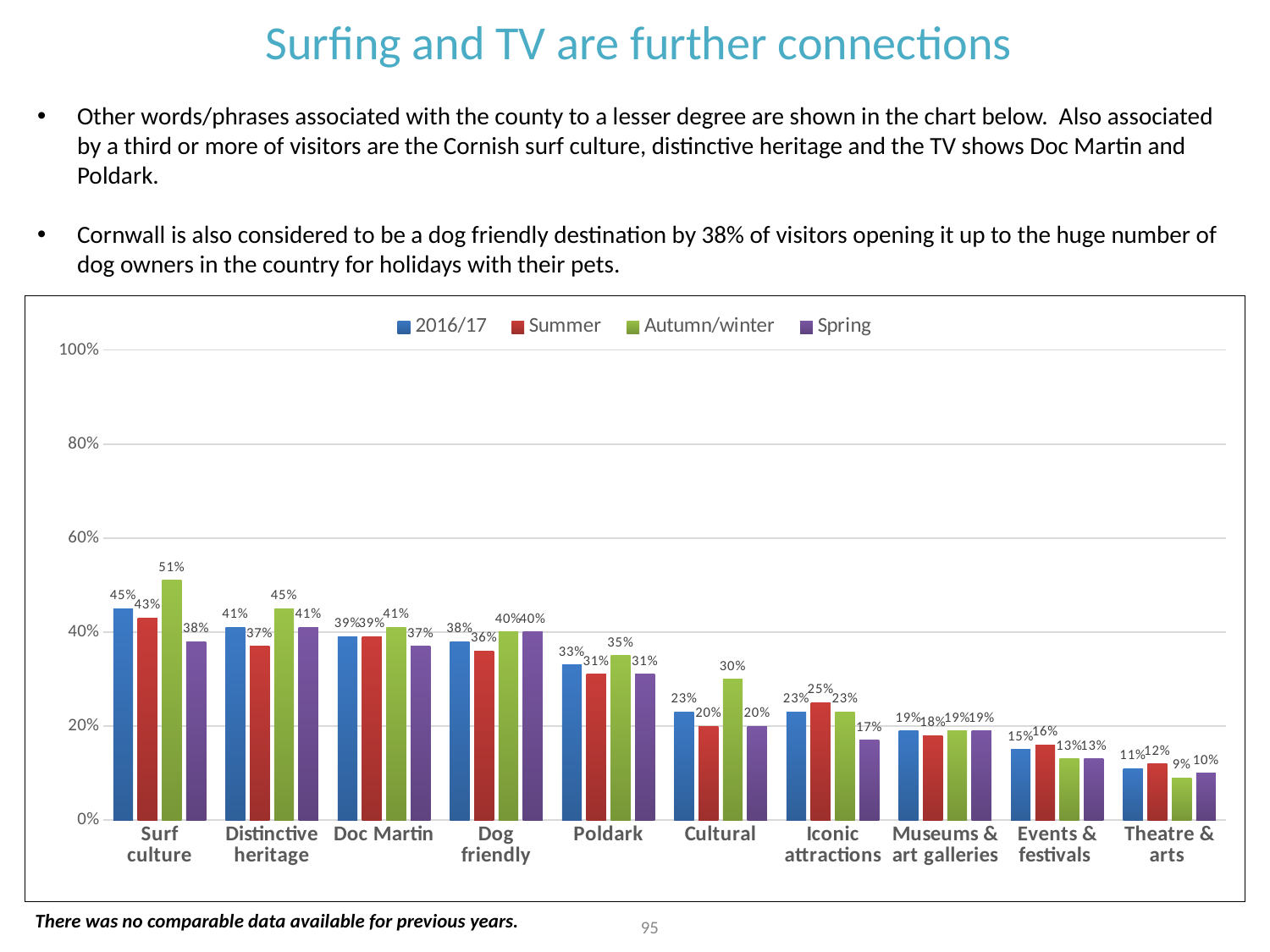
Which category has the highest Autumn/winter value? Surf culture What is the 2016/17 value for Dog friendly? 38% Which category has the lowest 2016/17 value? Theatre & arts How many series does the chart legend list? 4 Which is larger for Cultural: the Autumn/winter value or the Summer value? Autumn/winter What kind of chart is shown on the slide? Bar chart What is the Spring value for Iconic attractions? 17% What is the Autumn/winter value for Surf culture? 51% How many categories are shown on the x axis of the chart? 10 What is the Summer value for Poldark? 31% What is the difference between the Autumn/winter and Spring values for Surf culture? 13% Is the 2016/17 value for Distinctive heritage greater or less than 40%? greater